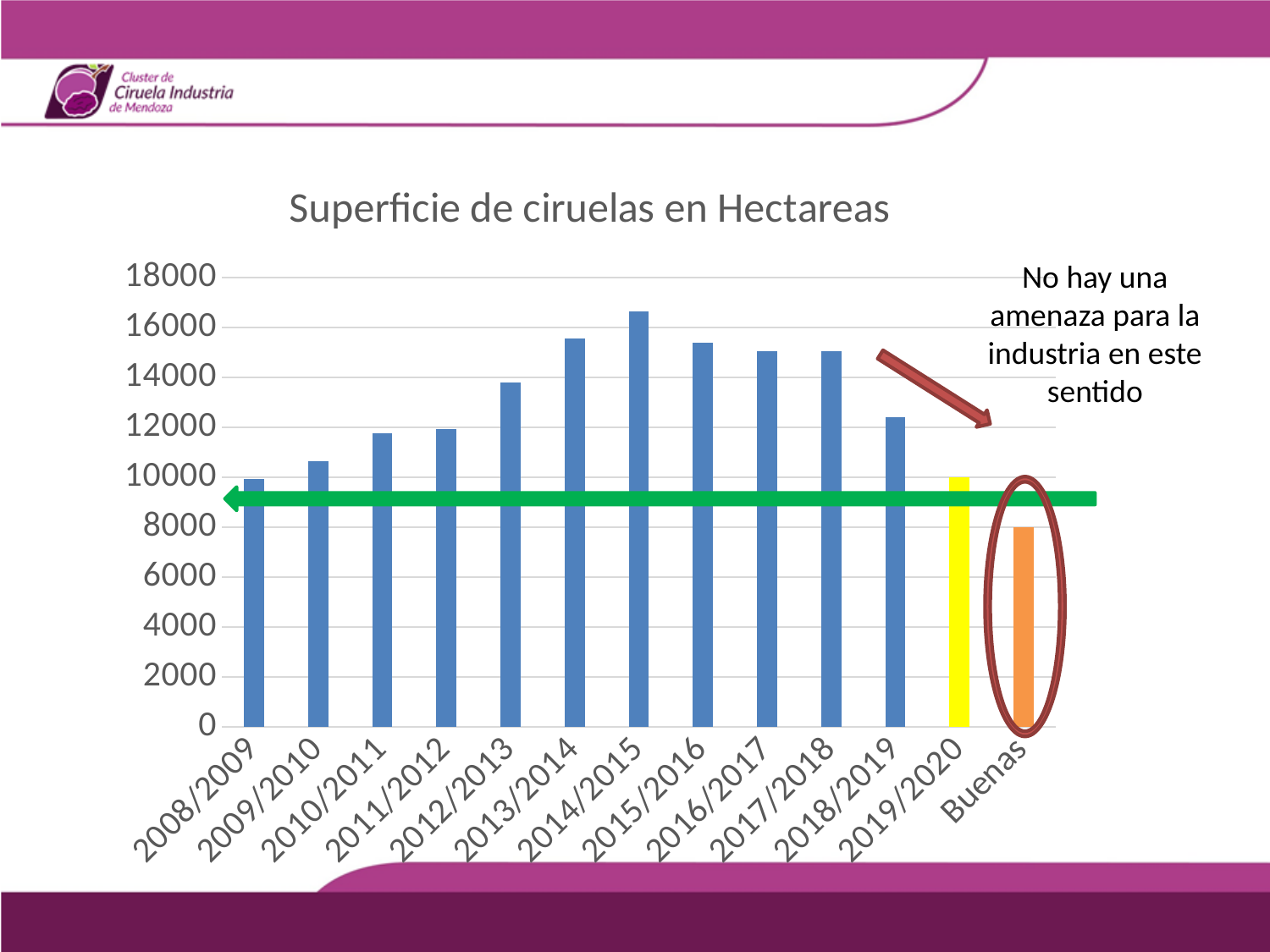
Is the value for 2009/2010 greater or less than 12000? less Is the value for 2012/2013 greater or less than 12000? greater What kind of chart is shown on the slide? bar chart Which category has the highest bar in the chart? 2014/2015 Is the value for 2013/2014 greater or less than 14000? greater What colour is the bar for the Buenas category? orange What is the title of the chart? Superficie de ciruelas en Hectareas Do the values rise or fall from 2008/2009 to 2014/2015? rise Which is larger, the value for 2014/2015 or the value for 2013/2014? 2014/2015 Which category has the lowest bar in the chart? Buenas How many categories are shown on the x axis of the chart? 13